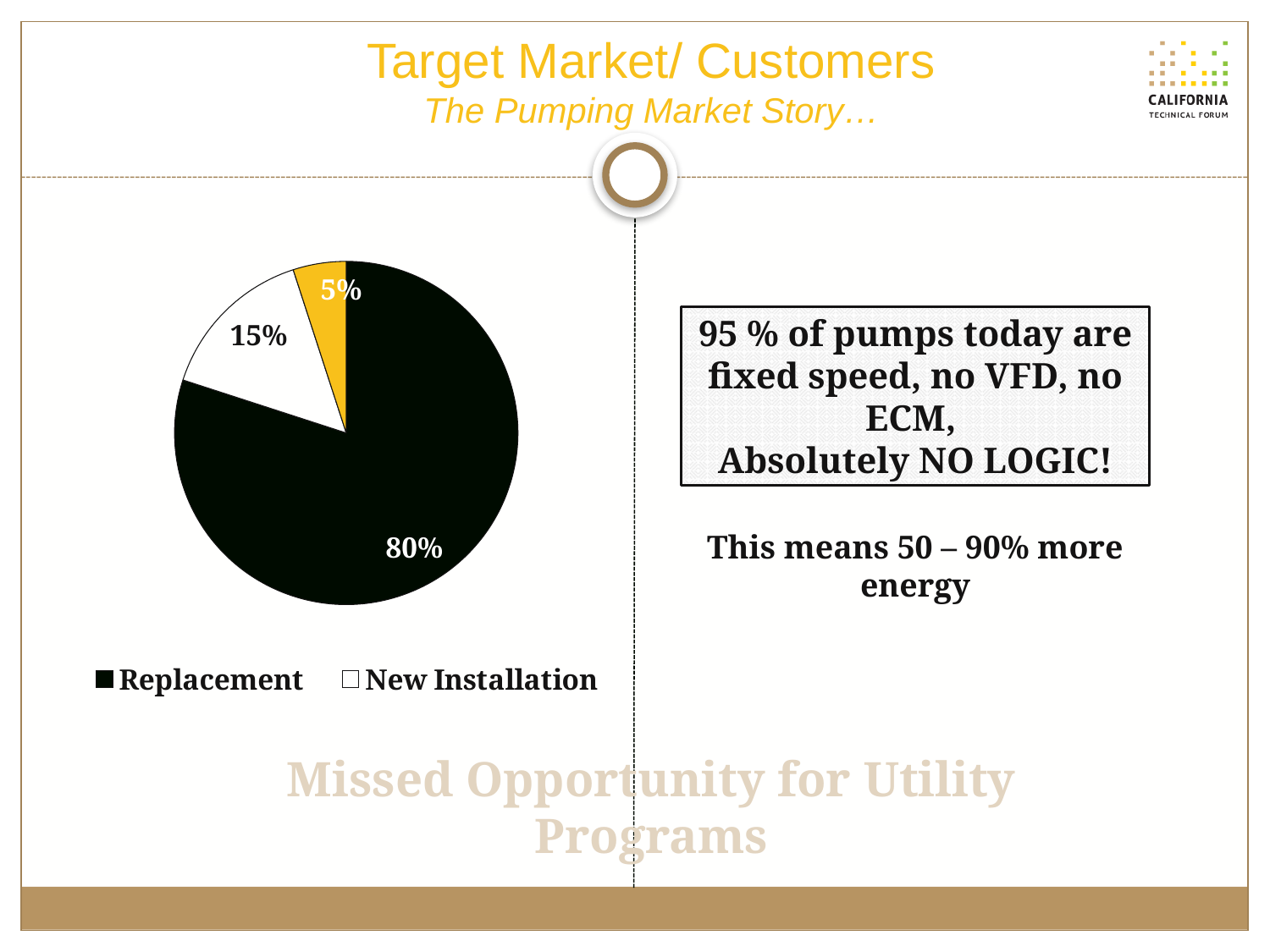
Which is larger, the Replacement slice or the New Installation slice? Replacement What colour is the Replacement slice of the pie? black What share of the pie does Replacement account for? 80% What colour is the New Installation slice of the pie? white What kind of chart is shown on the slide? pie chart Which category has the largest slice of the pie? Replacement What is the value shown on the smallest slice of the pie? 5% How many slices does the pie chart have? 3 Is the share for Replacement greater or less than 50%? greater How many entries does the legend list? 2 What is the difference in percentage points between the Replacement slice and the New Installation slice? 65 What share of the pie does New Installation account for? 15%